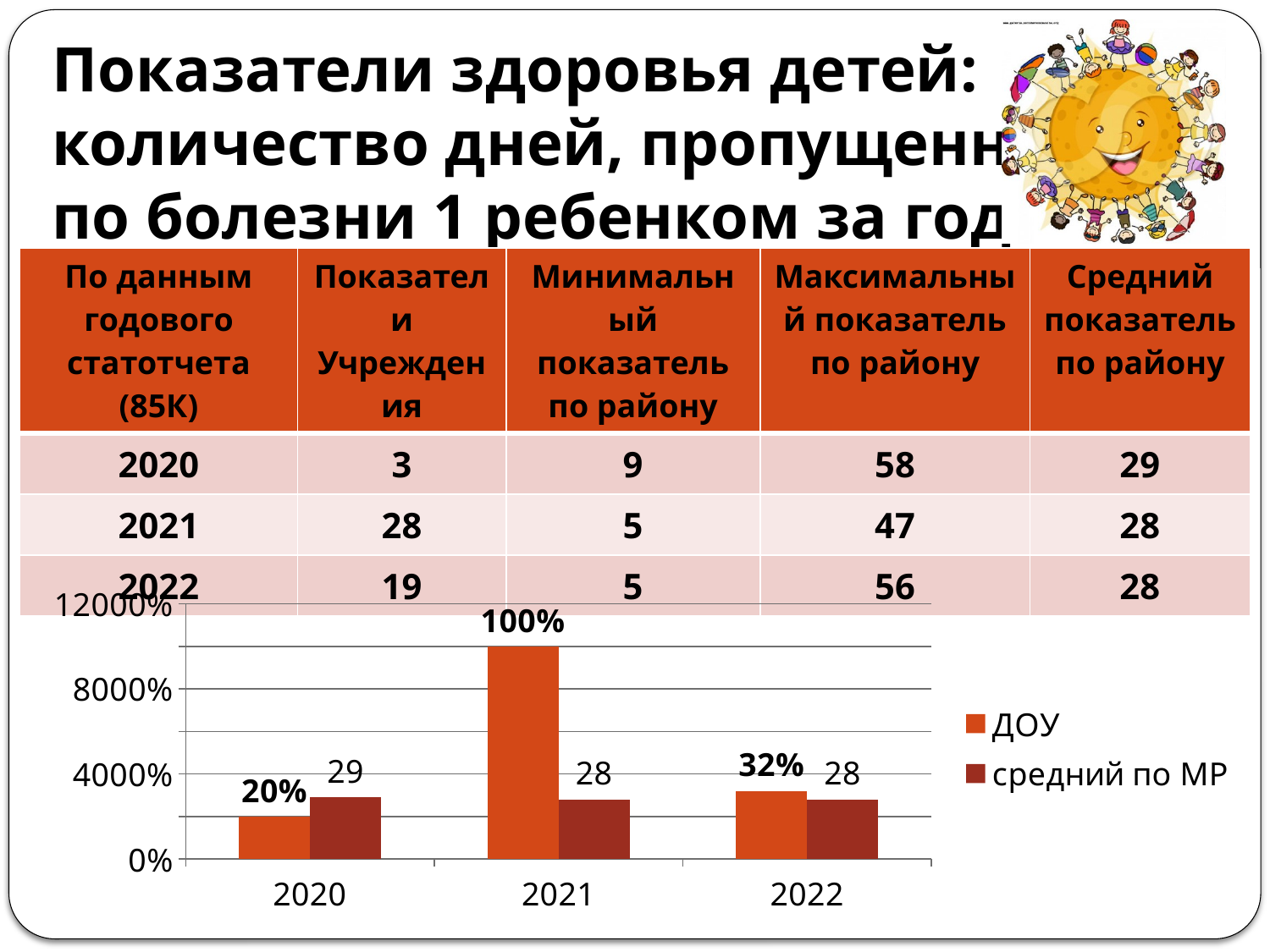
What is the value labelled for средний по МР in 2022? 28 In which year is the ДОУ value highest? 2021 How many series does the chart legend list? 2 In which year is the ДОУ value lowest? 2020 What is the value labelled for ДОУ in 2022? 32% What is the value labelled for ДОУ in 2020? 20% What is the value labelled for ДОУ in 2021? 100% What kind of chart is shown on the slide? Bar chart How many years are shown on the x axis of the chart? 3 What is the value labelled for средний по МР in 2020? 29 What is the difference between the ДОУ values for 2021 and 2020? 80% In 2021, which bar is taller: ДОУ or средний по МР? ДОУ